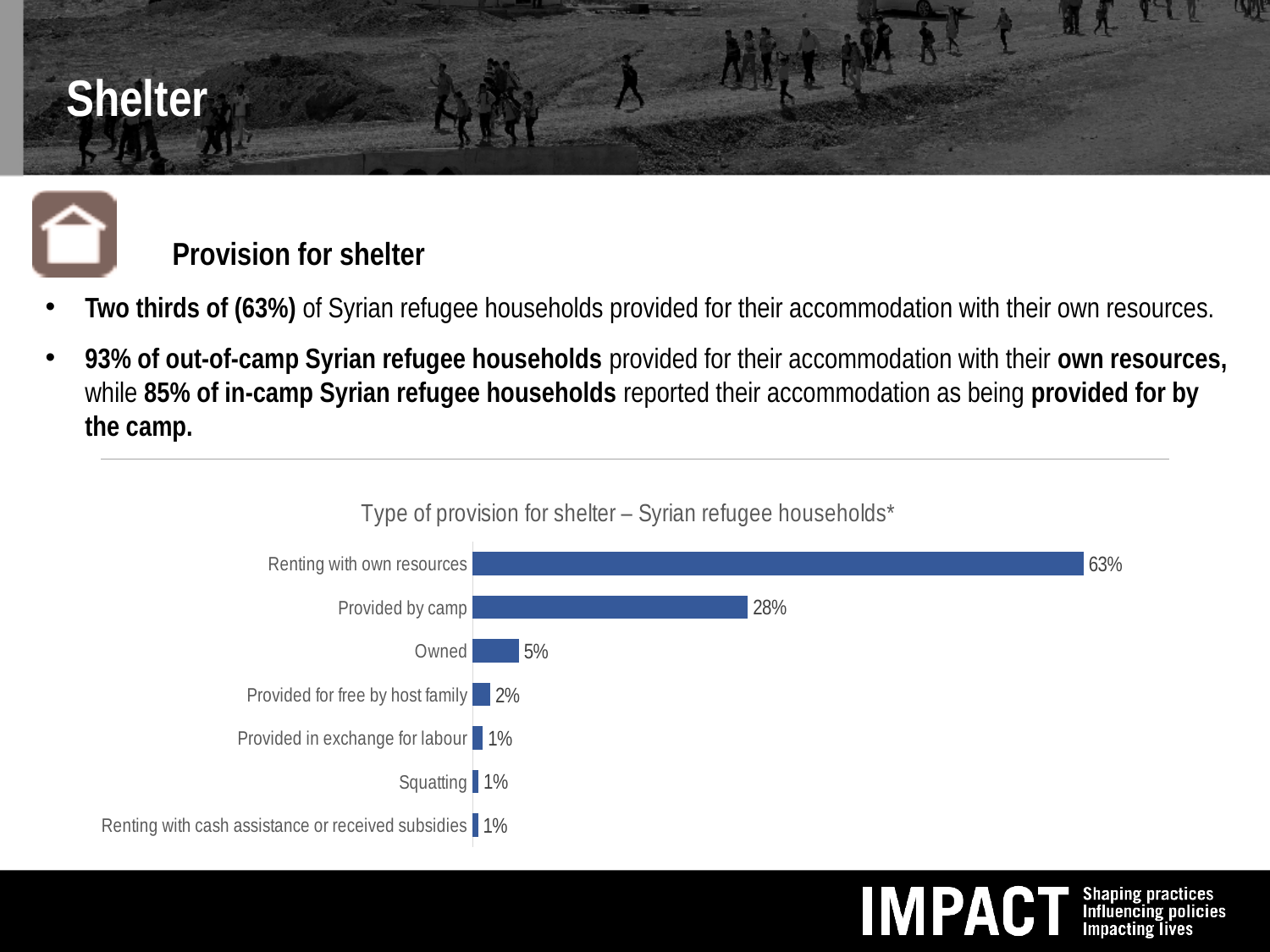
What is the value for 'Provided for free by host family'? 2% What is the difference between 'Provided by camp' and 'Owned'? 23% Which type of provision for shelter has the highest value? Renting with own resources What percentage of households reported their shelter as 'Owned'? 5% Which is larger: 'Owned' or 'Provided for free by host family'? Owned What is the title of the chart? Type of provision for shelter – Syrian refugee households* What kind of chart is shown on the slide? Bar chart What is the value for 'Provided by camp'? 28% What percentage of Syrian refugee households are renting with own resources? 63% What is the difference between 'Renting with own resources' and 'Provided by camp'? 35% How many categories are shown in the chart? 7 What is the value for 'Squatting'? 1%